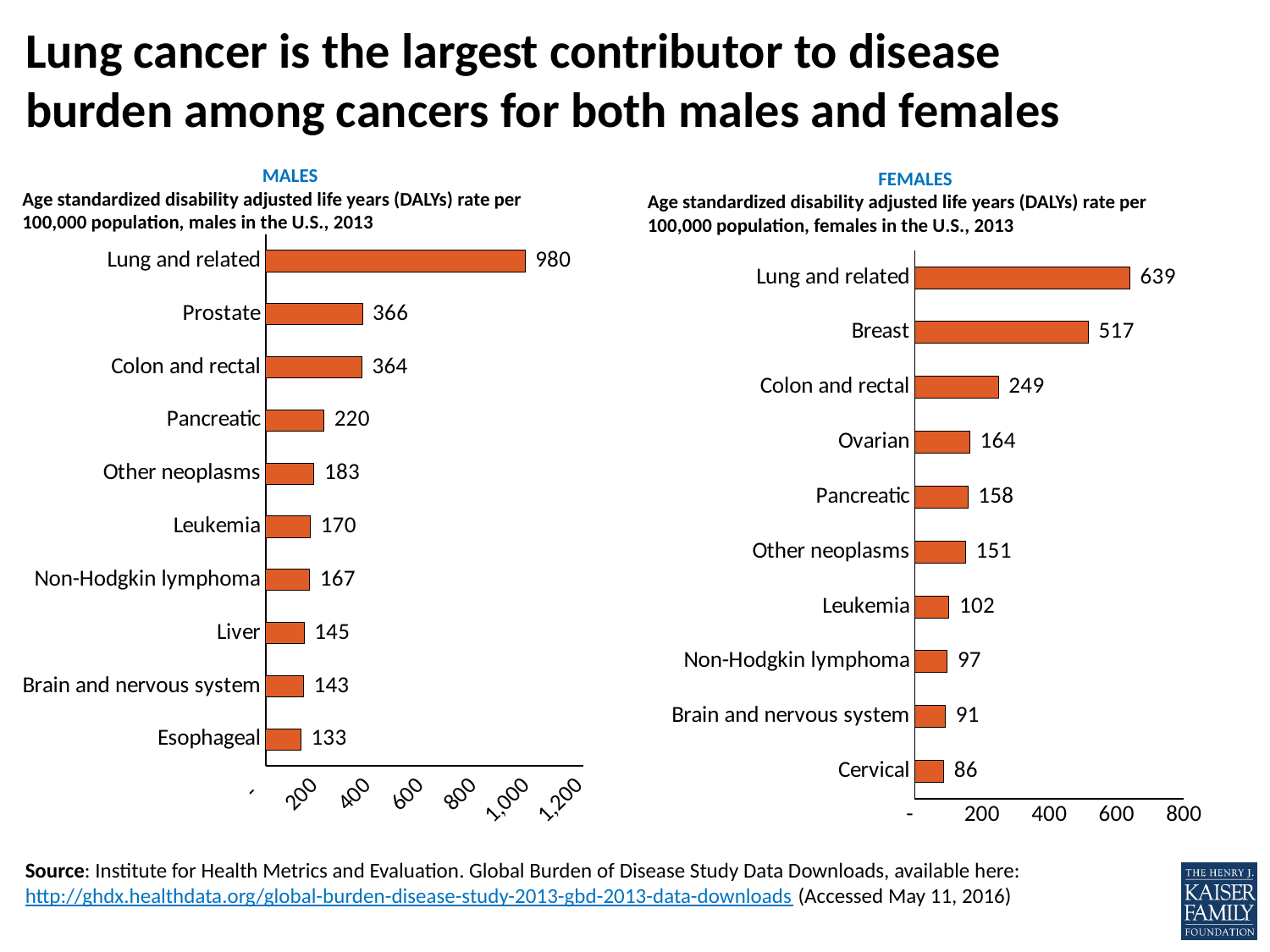
Which is larger: the Colon and rectal rate in the MALES chart or the Colon and rectal rate in the FEMALES chart? MALES chart (364) How many categories are shown in the FEMALES chart? 10 In the MALES chart, what is the DALYs rate for Prostate cancer? 366 In the MALES chart, which category has the highest DALYs rate? Lung and related In the MALES chart, is the value for Pancreatic greater or less than 200? greater In the FEMALES chart, which category has the lowest DALYs rate? Cervical In the FEMALES chart, what is the DALYs rate for Breast cancer? 517 How many categories are shown in the MALES chart? 10 In the FEMALES chart, what is the difference between the Lung and related rate and the Breast rate? 122 What type of chart is the FEMALES chart? Bar chart In the MALES chart, what is the DALYs rate for Esophageal cancer? 133 In the MALES chart, what is the difference between the Lung and related rate and the Prostate rate? 614